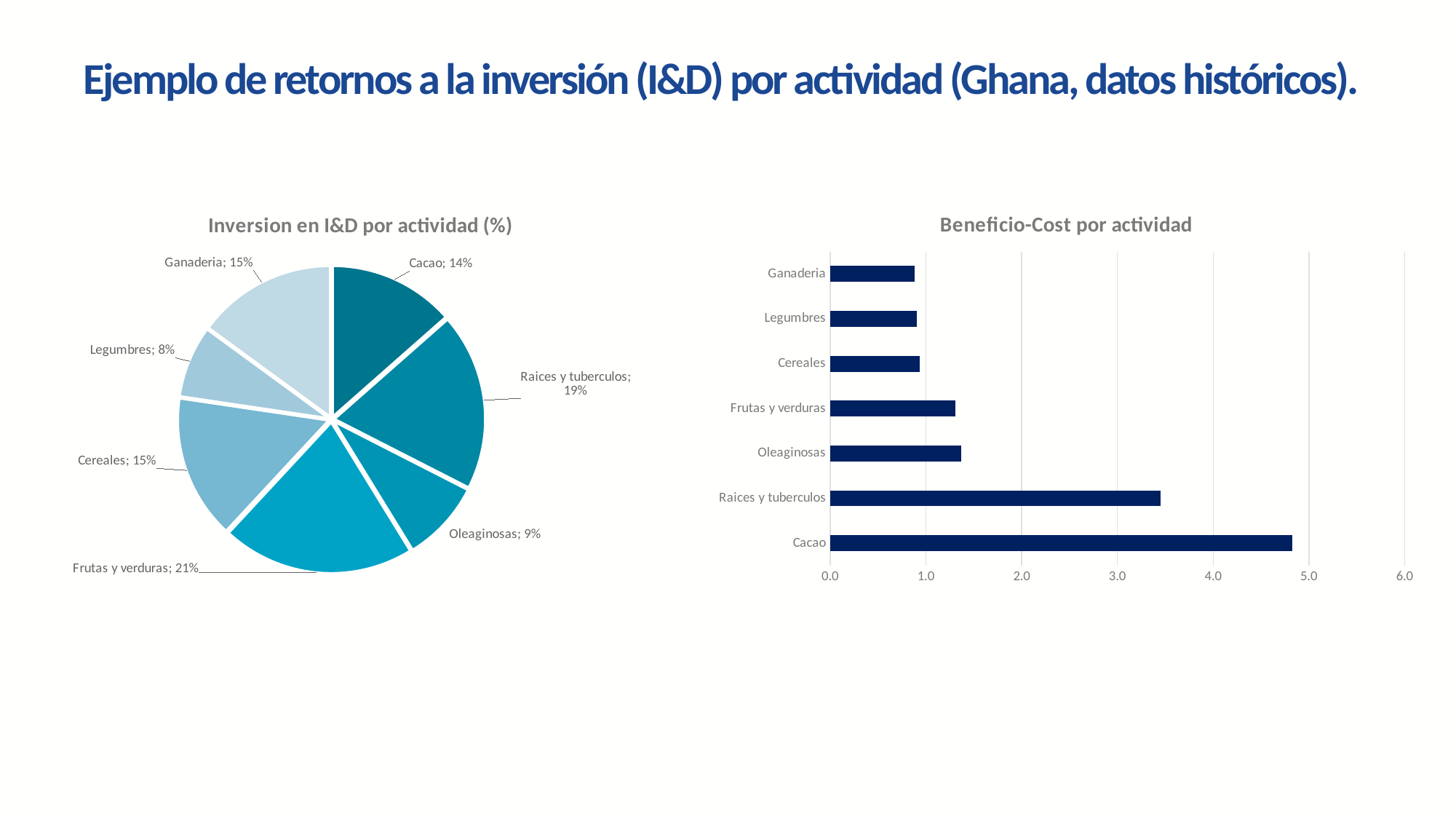
In the 'Beneficio-Cost por actividad' chart, is the value for Ganaderia greater or less than 1.0? less In the 'Inversion en I&D por actividad (%)' chart, which category has the smallest share? Legumbres How many categories are shown in the 'Inversion en I&D por actividad (%)' pie chart? 7 In the 'Inversion en I&D por actividad (%)' chart, what is the value for Frutas y verduras? 21% What kind of chart is 'Inversion en I&D por actividad (%)'? Pie chart In the 'Inversion en I&D por actividad (%)' chart, which is larger, the share for Cacao or the share for Cereales? Cereales In the 'Inversion en I&D por actividad (%)' chart, what is the difference between the shares of Frutas y verduras and Oleaginosas? 12% In the 'Inversion en I&D por actividad (%)' chart, which category has the largest share? Frutas y verduras In the 'Beneficio-Cost por actividad' chart, which category has the highest value? Cacao In the 'Inversion en I&D por actividad (%)' chart, what is the value for Raices y tuberculos? 19% What kind of chart is 'Beneficio-Cost por actividad'? Bar chart In the 'Beneficio-Cost por actividad' chart, is the value for Raices y tuberculos greater or less than 3.0? greater